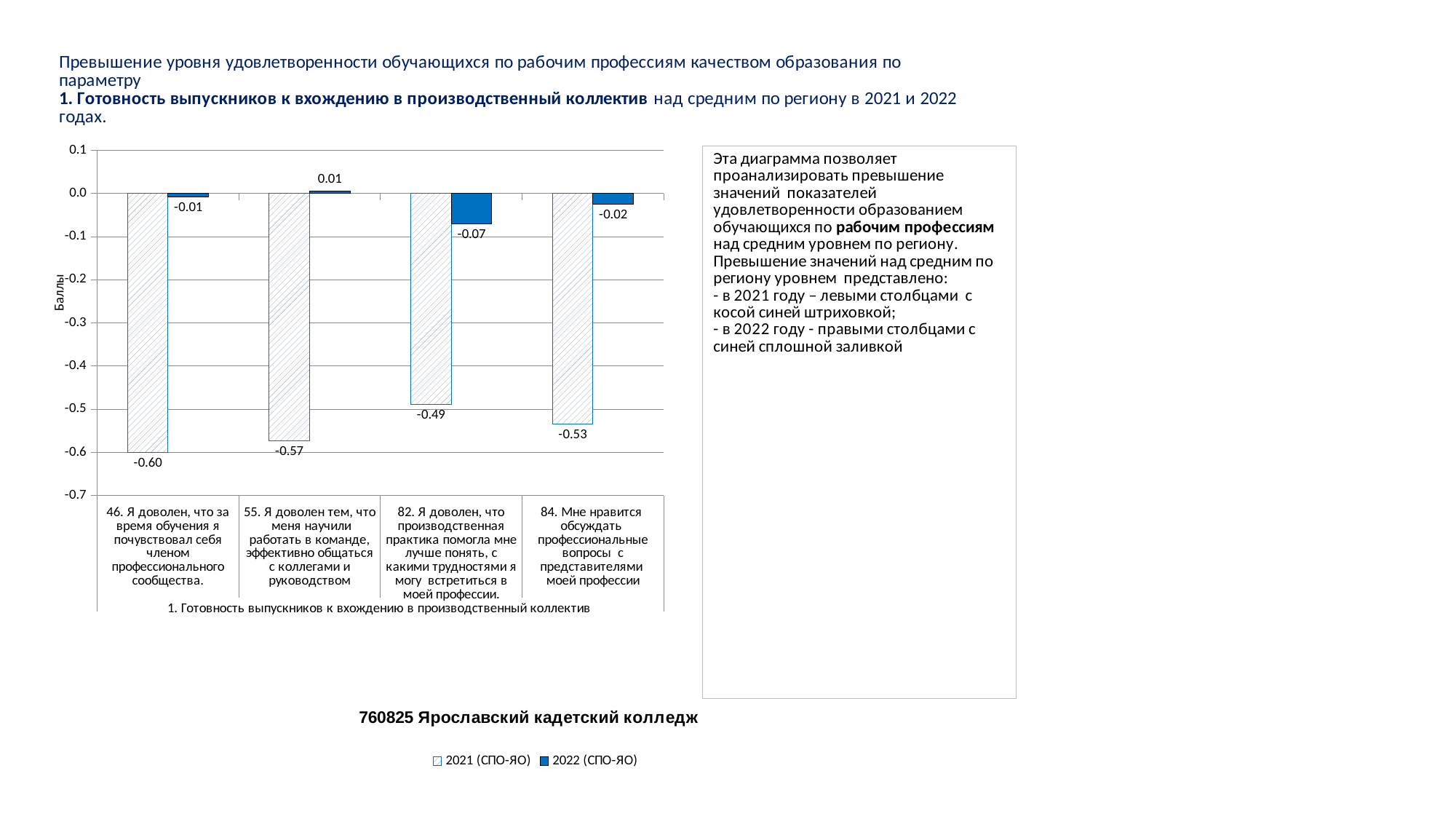
What is the 2021 (СПО-ЯО) value for category 46 ("Я доволен, что за время обучения я почувствовал себя членом профессионального сообщества")? -0.60 Which category has the lowest 2021 (СПО-ЯО) value? 46. Я доволен, что за время обучения я почувствовал себя членом профессионального сообщества. What kind of chart is shown on the slide? Bar chart Which category has the highest 2022 (СПО-ЯО) value? 55. Я доволен тем, что меня научили работать в команде, эффективно общаться с коллегами и руководством What is the 2022 (СПО-ЯО) value for category 55 ("Я доволен тем, что меня научили работать в команде...")? 0.01 Which is larger for category 84: the 2021 (СПО-ЯО) value or the 2022 (СПО-ЯО) value? 2022 (СПО-ЯО) What is the label of the vertical axis of the chart? Баллы What is the difference between the 2021 and 2022 values for category 82? 0.42 How many series does the legend list? 2 What is the 2022 (СПО-ЯО) value for category 82 ("Я доволен, что производственная практика помогла мне лучше понять...")? -0.07 What is the 2021 (СПО-ЯО) value for category 84 ("Мне нравится обсуждать профессиональные вопросы...")? -0.53 How many categories are shown on the x axis of the chart? 4